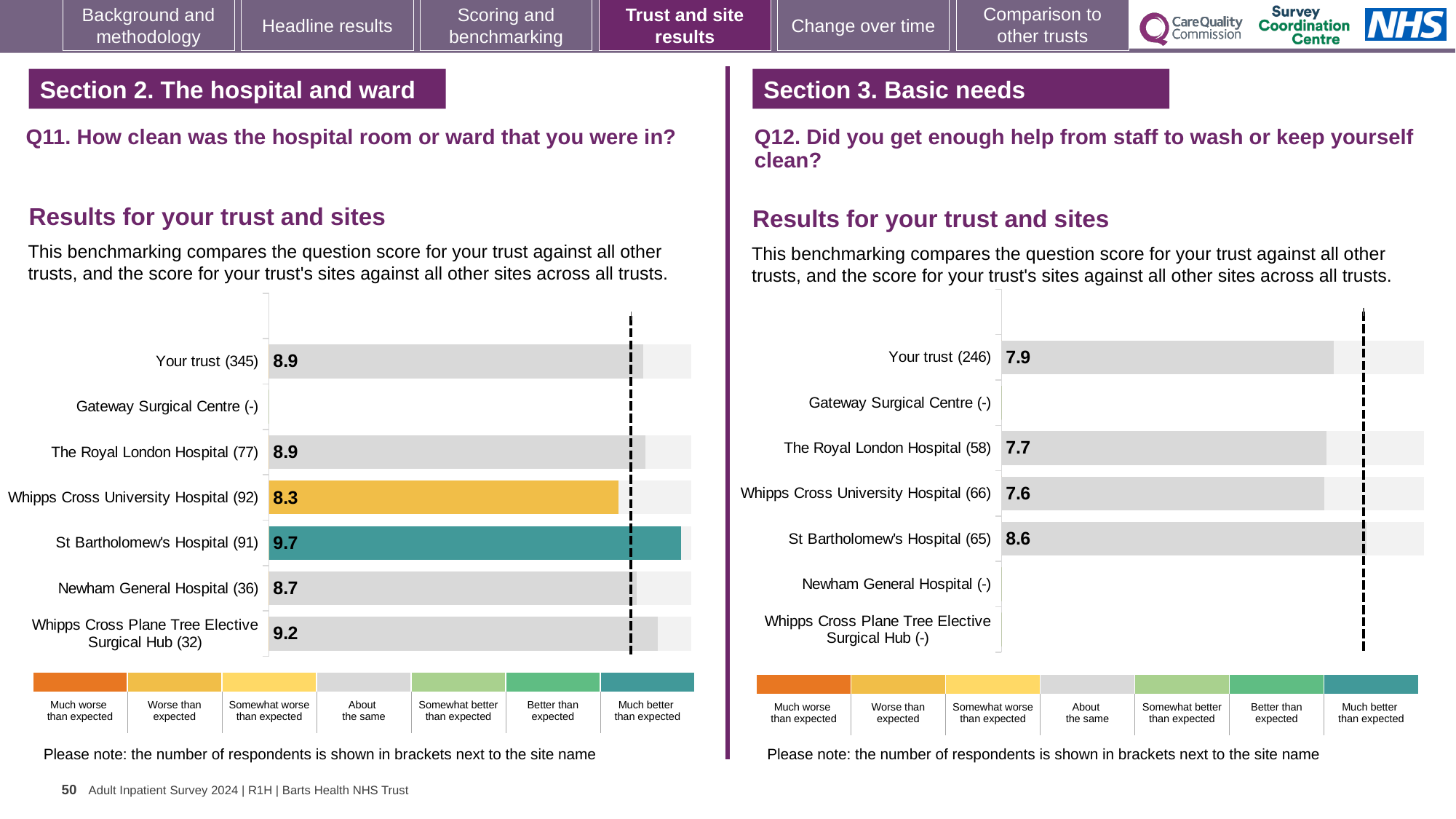
In the Q12 chart (right), what is the score for Your trust? 7.9 In the Q11 chart (left), which site has the lowest score among those with a value shown? Whipps Cross University Hospital In the Q12 chart (right), what is the difference between the scores for St Bartholomew's Hospital and Whipps Cross University Hospital? 1.0 In the Q11 chart (left), which has the higher score: Newham General Hospital or Whipps Cross Plane Tree Elective Surgical Hub? Whipps Cross Plane Tree Elective Surgical Hub In the Q12 chart (right), which site has the highest score? St Bartholomew's Hospital In the Q12 chart (right), what is the score for The Royal London Hospital? 7.7 In the Q11 chart (left), what is the score for Whipps Cross University Hospital? 8.3 What type of chart is used for the Q11 results on the left? Bar chart In the Q11 chart (left), which site has the highest score? St Bartholomew's Hospital In the Q11 chart (left), what is the difference between the scores for St Bartholomew's Hospital and Whipps Cross University Hospital? 1.4 In the Q11 chart (left), what is the score for St Bartholomew's Hospital? 9.7 In the Q12 chart (right), how many sites (including Your trust) are listed on the axis? 7